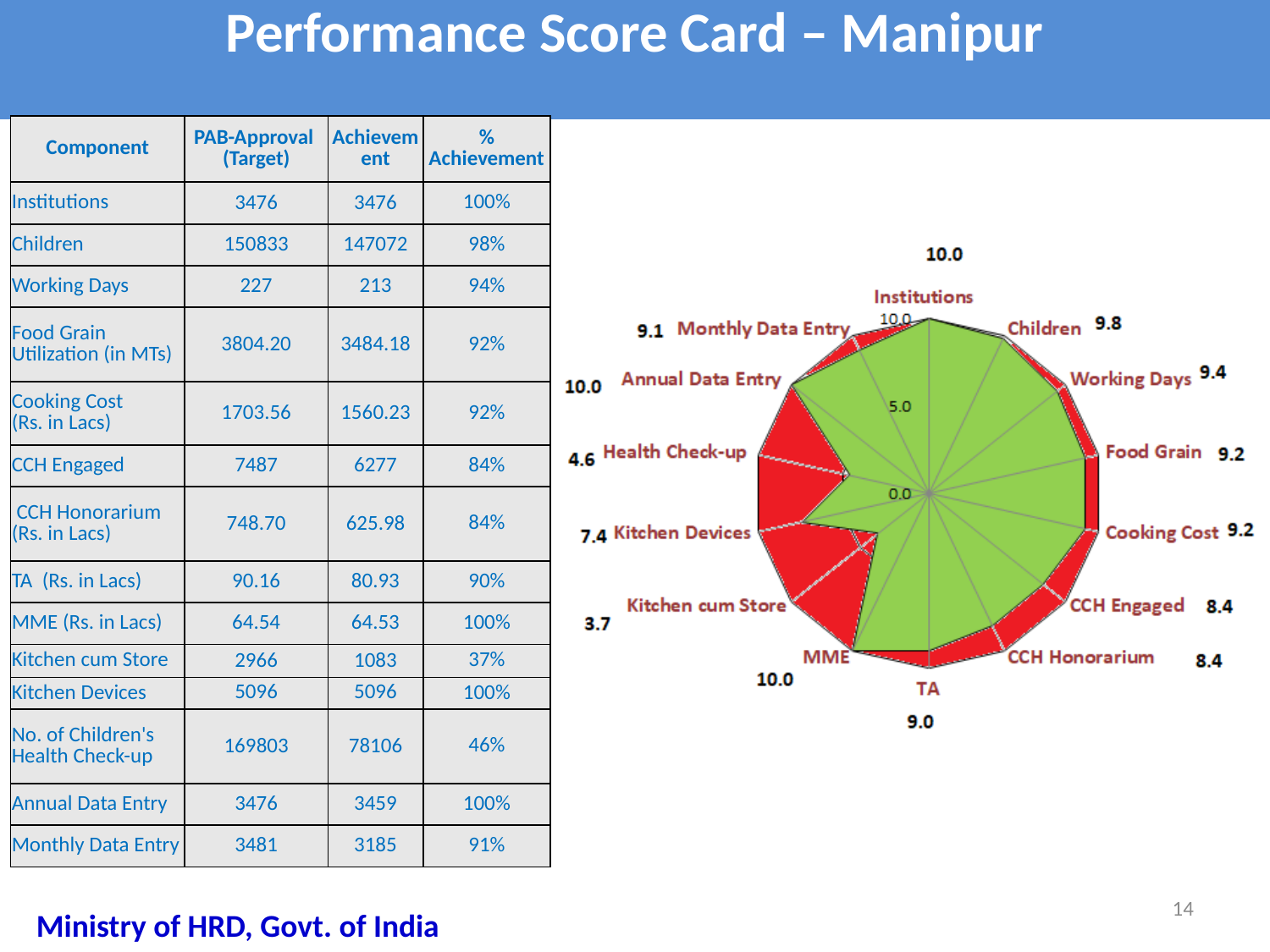
Which category has the lowest value on the radar chart? Kitchen cum Store What is the value for Health Check-up on the radar chart? 4.6 What kind of chart is shown on the slide? radar chart What is the value for Children on the radar chart? 9.8 Is the value for Kitchen Devices on the radar chart greater or less than 5.0? greater What is the value for Kitchen Devices on the radar chart? 7.4 Which has a larger value on the radar chart, Working Days or Health Check-up? Working Days What is the difference between the values for Children and Kitchen cum Store on the radar chart? 6.1 What is the value for Kitchen cum Store on the radar chart? 3.7 What is the highest tick value shown on the radar chart's axis? 10.0 How many categories are plotted on the radar chart? 14 What is the value for Monthly Data Entry on the radar chart? 9.1